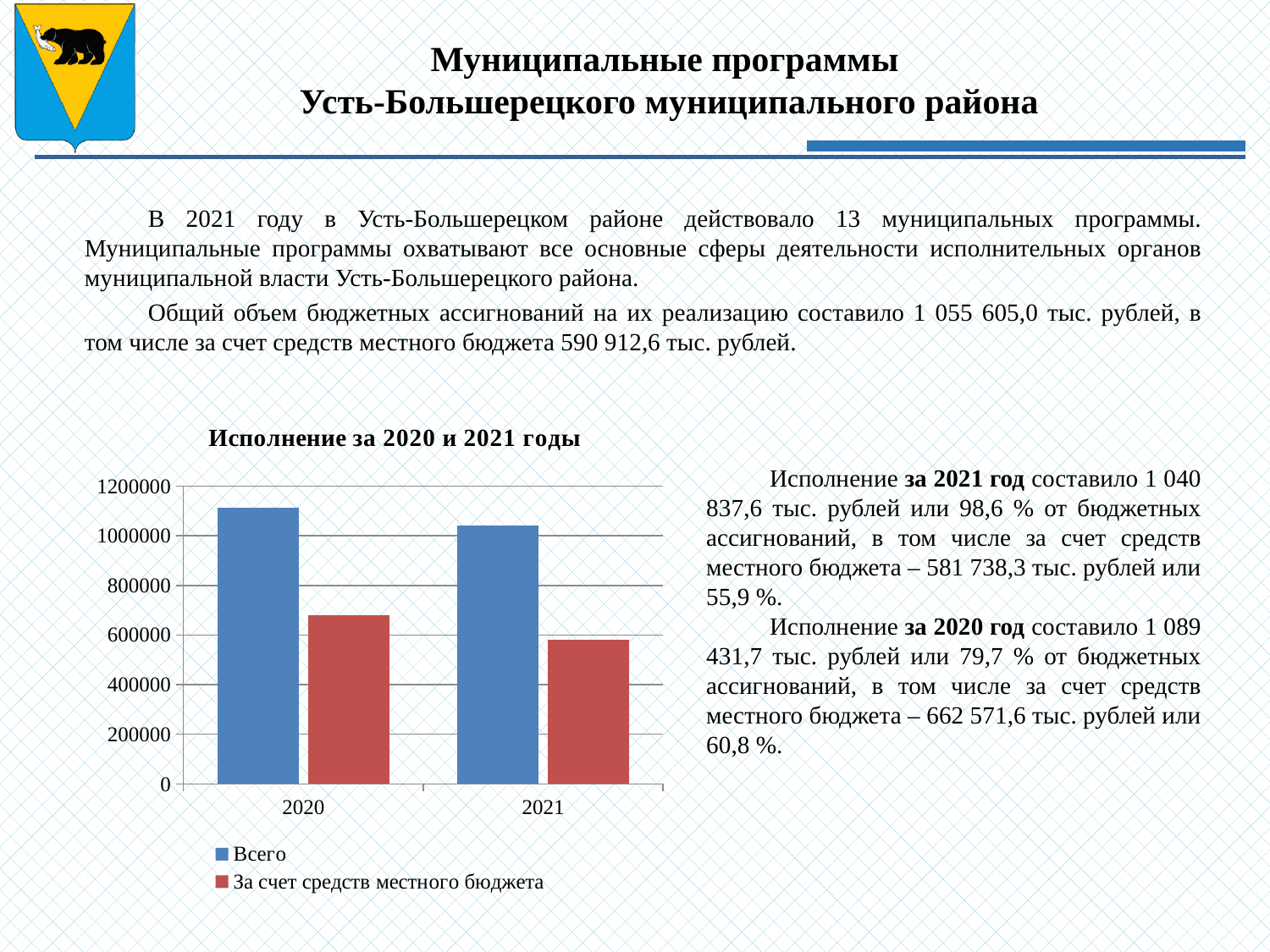
How many year categories are shown on the x axis of the chart? 2 Which year has the larger value for "За счет средств местного бюджета", 2020 or 2021? 2020 How many series does the legend of the chart list? 2 Is the value for "За счет средств местного бюджета" in 2020 greater or less than 800000? less What is the title of the chart on the slide? Исполнение за 2020 и 2021 годы What kind of chart is shown under the title "Исполнение за 2020 и 2021 годы"? bar chart Is the value for "Всего" in 2021 greater or less than 800000? greater Is the value for "За счет средств местного бюджета" in 2021 greater or less than 400000? greater Which bar in the chart is the lowest? За счет средств местного бюджета, 2021 Does the "За счет средств местного бюджета" series rise or fall from 2020 to 2021? fall What are the two series named in the chart legend? Всего; За счет средств местного бюджета